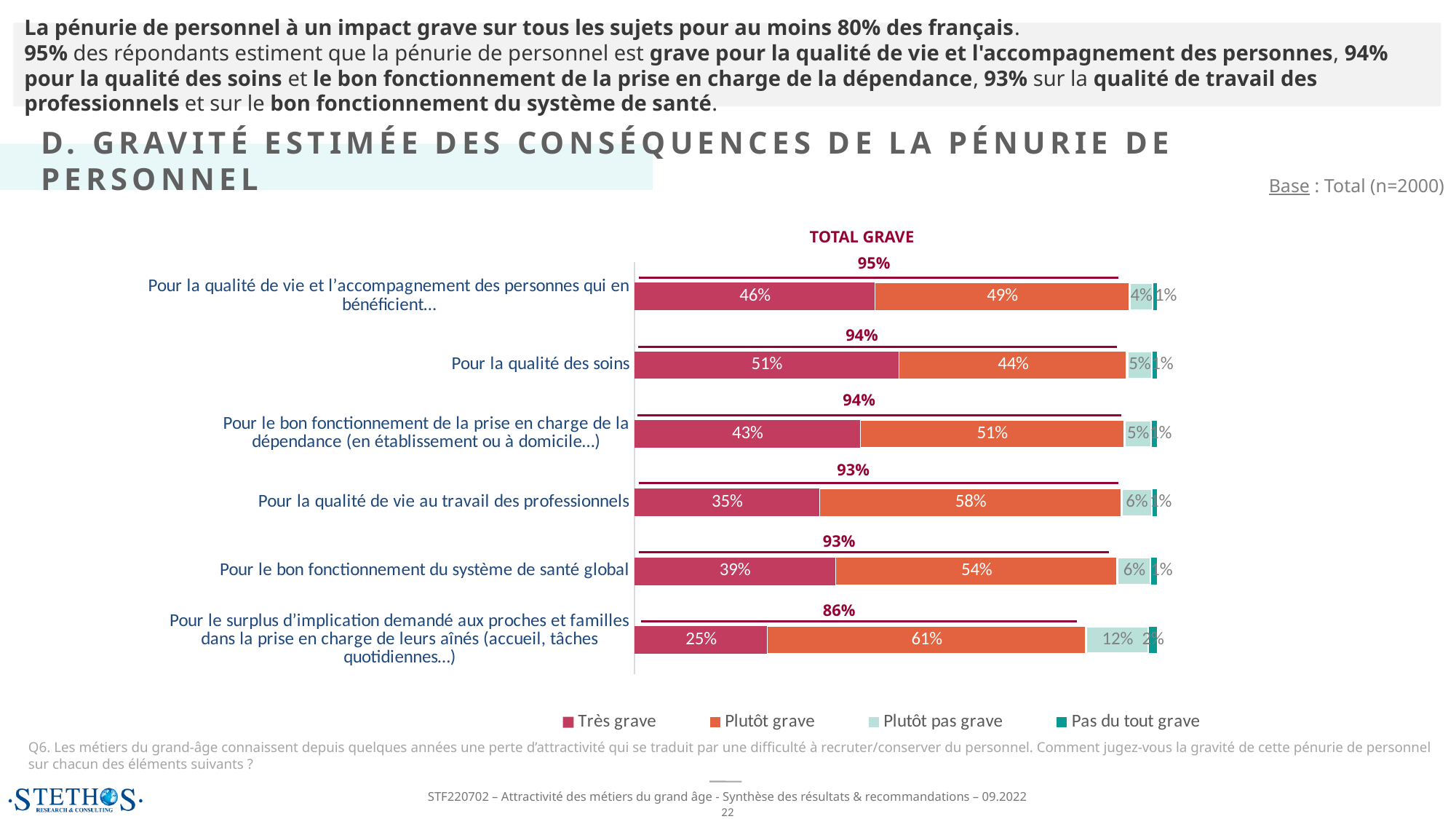
Which is larger: the "Très grave" value for "Pour la qualité de vie et l'accompagnement des personnes qui en bénéficient" or for "Pour le bon fonctionnement du système de santé global"? Pour la qualité de vie et l'accompagnement des personnes qui en bénéficient What kind of chart is shown on the slide? Stacked bar chart What is the "Plutôt grave" value for "Pour la qualité de vie au travail des professionnels"? 58% What is the difference between the "Plutôt grave" value and the "Très grave" value for "Pour le surplus d'implication demandé aux proches et familles"? 36% What is the "Très grave" value for "Pour la qualité des soins"? 51% How many series does the legend list? 4 How many categories are shown in the chart? 6 What is the combined "Très grave" and "Plutôt grave" total for "Pour le bon fonctionnement de la prise en charge de la dépendance"? 94% Which category has the lowest TOTAL GRAVE value? Pour le surplus d'implication demandé aux proches et familles dans la prise en charge de leurs aînés (accueil, tâches quotidiennes…) What is the TOTAL GRAVE value shown for "Pour le bon fonctionnement du système de santé global"? 93% Which category has the highest "Très grave" value? Pour la qualité des soins What is the "Plutôt pas grave" value for "Pour le surplus d'implication demandé aux proches et familles dans la prise en charge de leurs aînés"? 12%